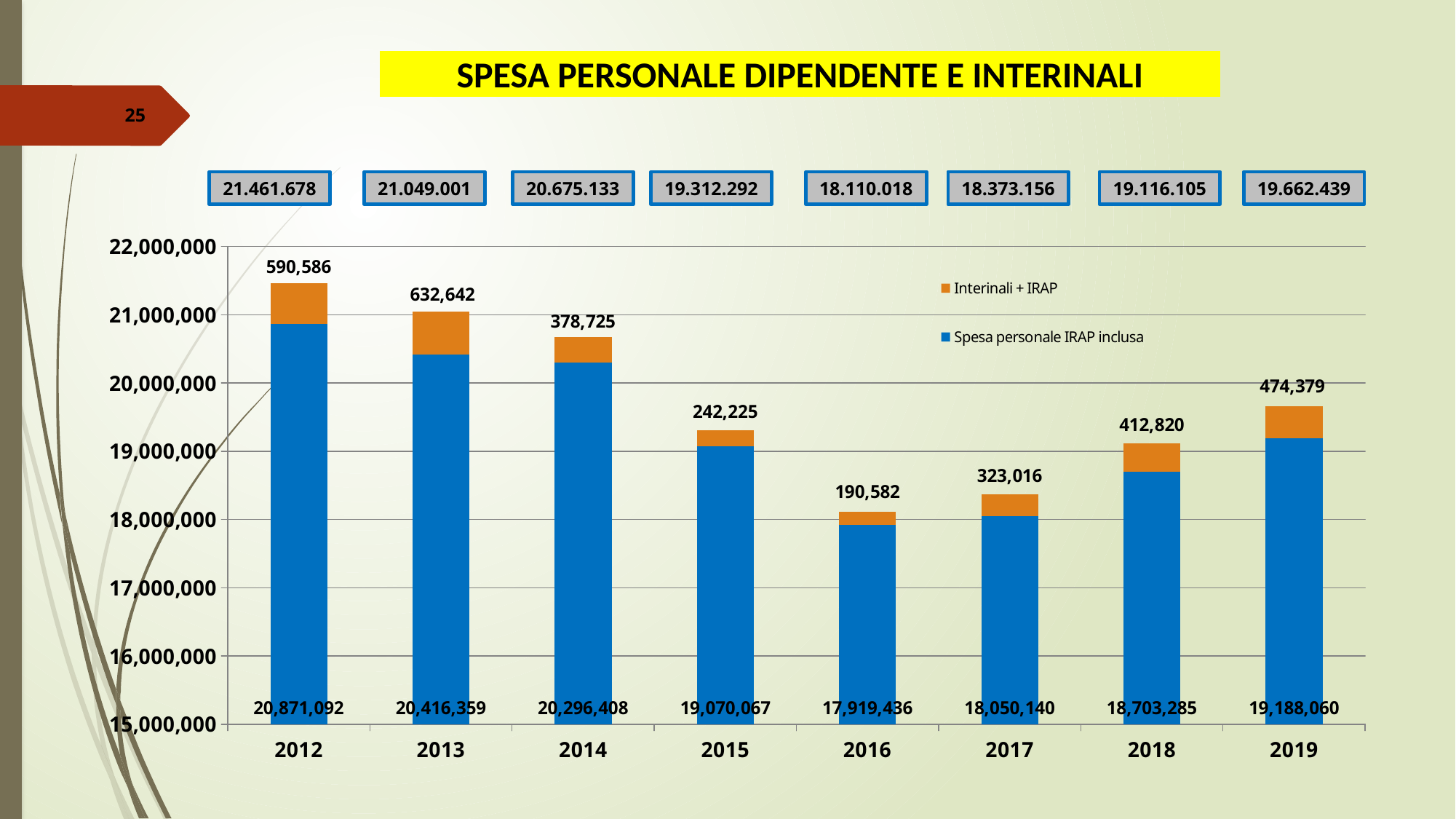
What is the difference between the Interinali + IRAP values for 2013 and 2016? 442,060 In which year is the Spesa personale IRAP inclusa value lowest? 2016 In which year is the Interinali + IRAP value highest? 2013 What is the value of Spesa personale IRAP inclusa for 2016? 17,919,436 What is the total of the stacked bar for 2016, as shown in the box above the chart? 18.110.018 How many series does the legend list? 2 What is the value of Interinali + IRAP for 2013? 632,642 How many years are shown on the x axis of the chart? 8 Do the Spesa personale IRAP inclusa values rise or fall from 2012 to 2016? Fall What is the difference between the Spesa personale IRAP inclusa values for 2012 and 2019? 1,683,032 Which year has the larger Interinali + IRAP value, 2018 or 2019? 2019 What kind of chart is shown on the slide? Stacked bar chart